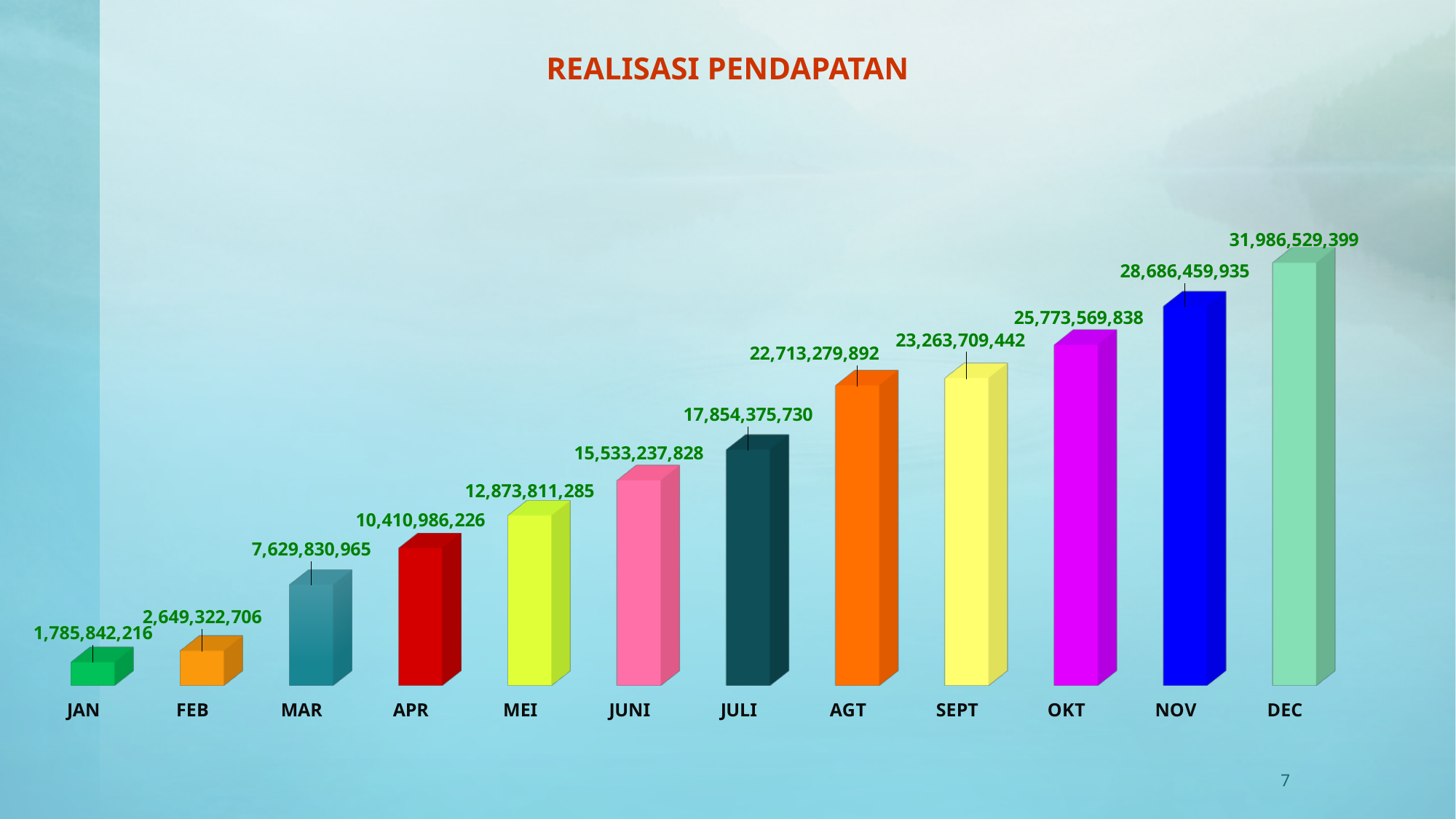
How many months are shown on the chart? 12 What is the title of the chart? REALISASI PENDAPATAN Which is larger, the value for APR or the value for MEI? MEI Do the values rise or fall from JAN to DEC? Rise What is the value for JUNI? 15,533,237,828 What kind of chart is shown on the slide? Bar chart What is the value for MAR? 7,629,830,965 What is the difference between the values for DEC and NOV? 3,300,069,464 Which month has the lowest value? JAN What is the value for SEPT? 23,263,709,442 Which month has the highest value? DEC What is the difference between the values for AGT and JULI? 4,858,904,162